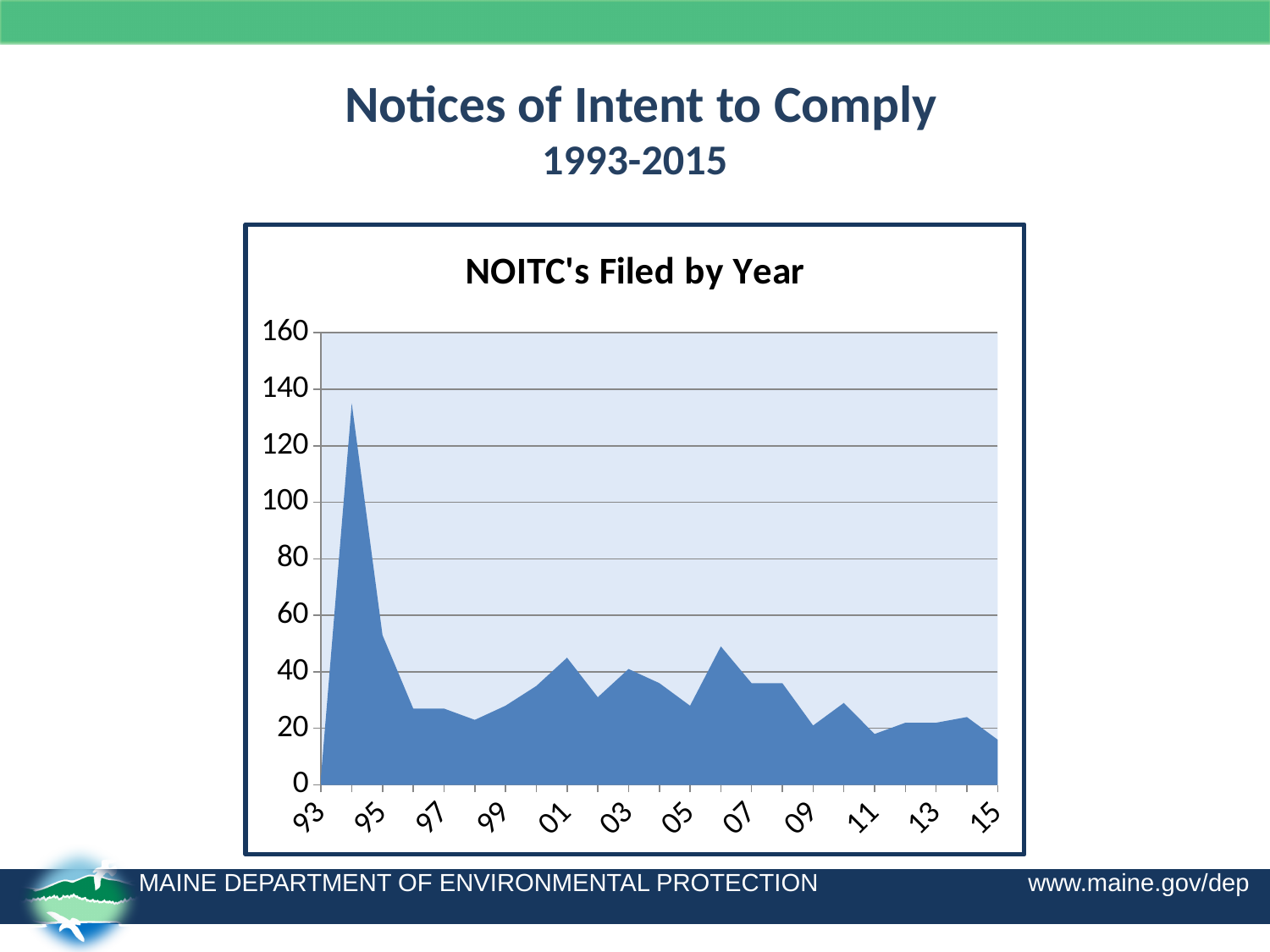
What is the title of the chart? NOITC's Filed by Year Is the value for 95 greater or less than 60? less Is the value for 94 greater or less than 120? greater What kind of chart is shown on the slide? area chart Is the value for 06 greater or less than 40? greater What is the highest value shown on the vertical axis? 160 Which year has the highest number of NOITC's filed? 94 Do the values rise or fall from 94 to 98? fall Which is larger, the value for 94 or the value for 06? 94